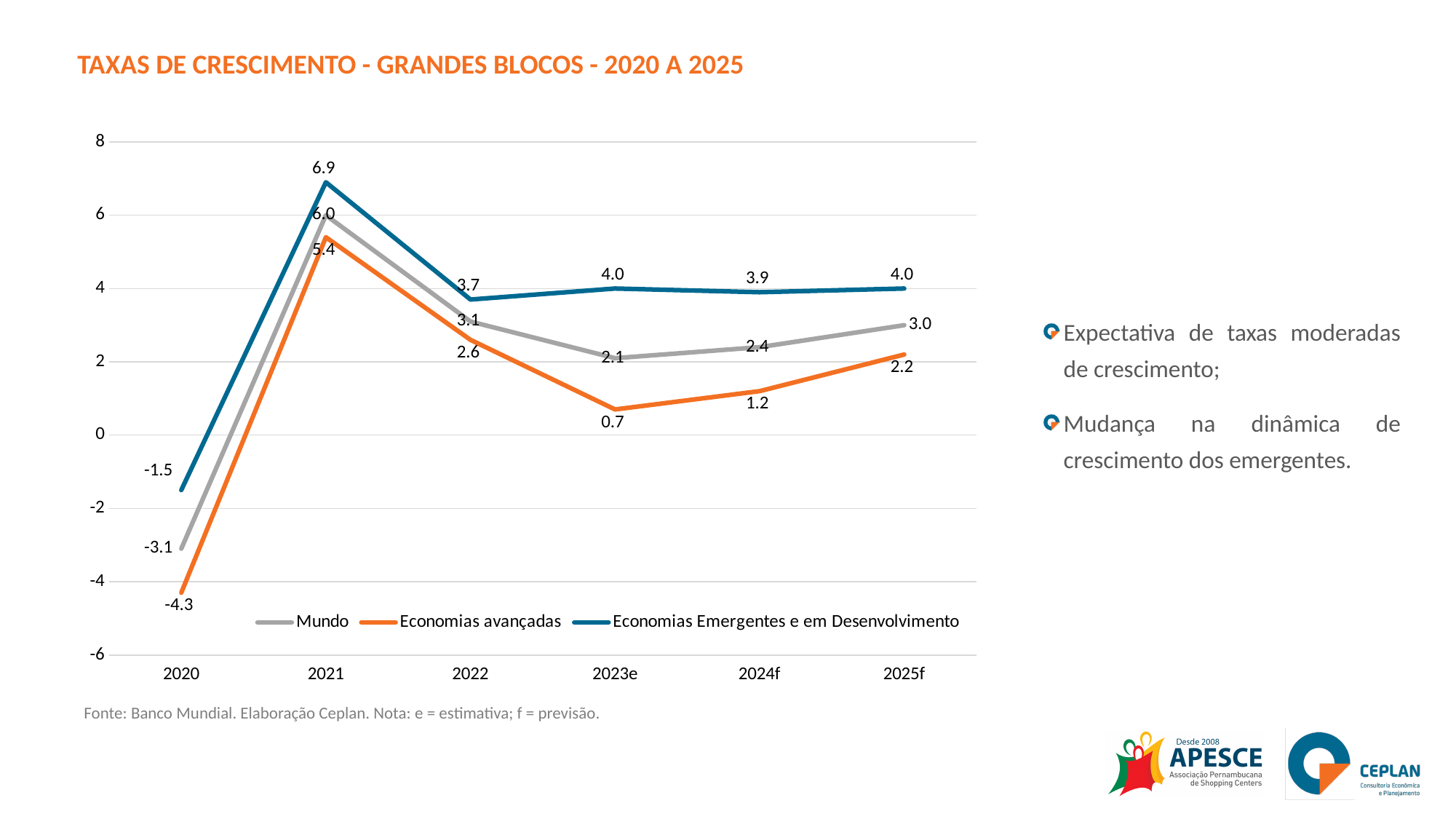
How many series does the legend list? 3 What kind of chart is shown on the slide? Line chart What is the value for Economias avançadas in 2023e? 0.7 In which year does the Mundo series reach its highest value? 2021 What is the value for Economias avançadas in 2020? -4.3 How many years are shown on the x axis? 6 In which year does the Economias avançadas series have its lowest value? 2020 What is the value for Economias Emergentes e em Desenvolvimento in 2021? 6.9 What is the difference between Economias Emergentes e em Desenvolvimento and Economias avançadas in 2023e? 3.3 Does the Economias avançadas series rise or fall from 2023e to 2025f? Rise What is the value for Mundo in 2025f? 3.0 Which is larger in 2024f: Mundo or Economias avançadas? Mundo